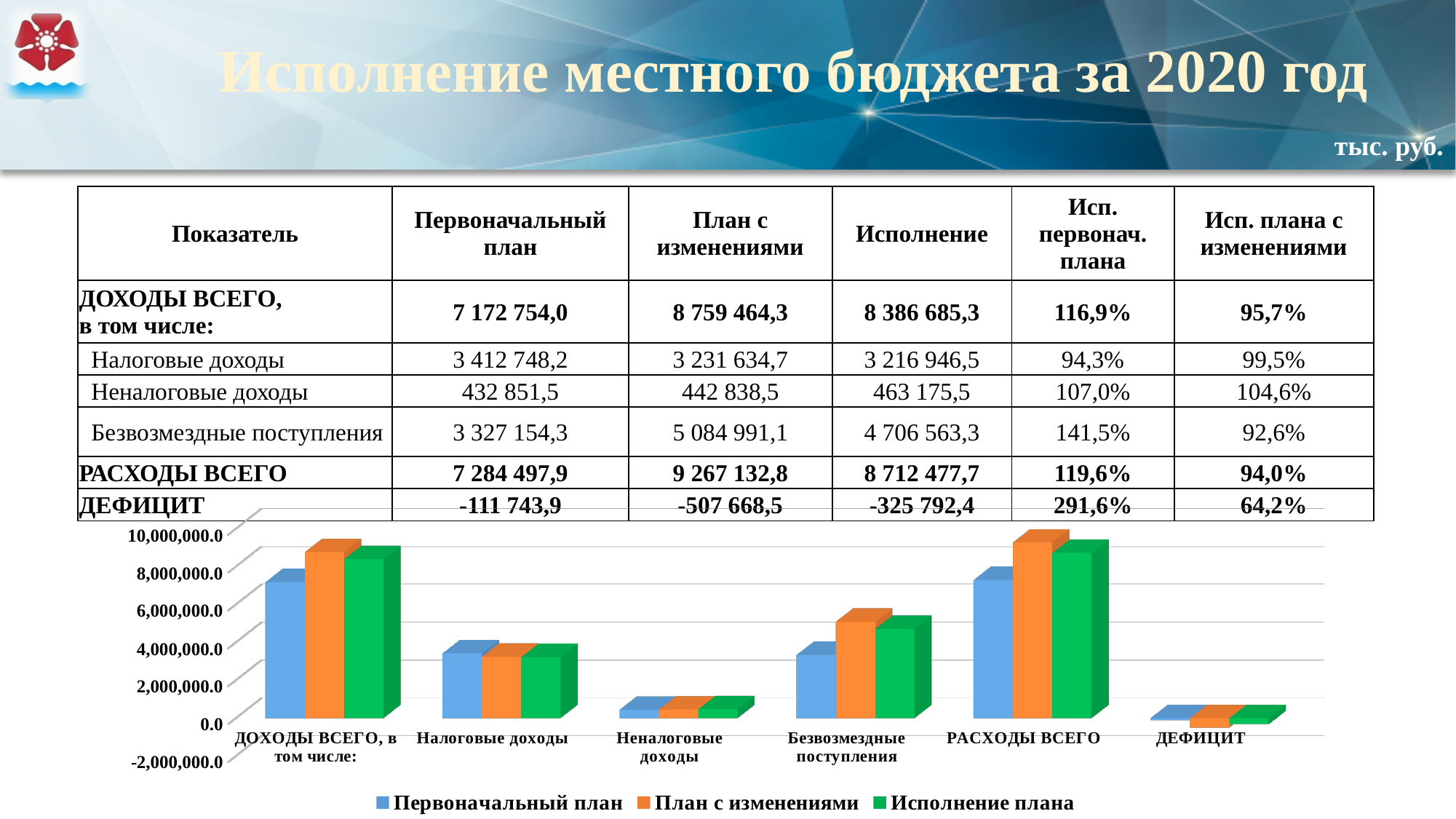
How many categories are shown along the x axis of the chart? 6 For the 'Исполнение плана' series, which is larger: 'Налоговые доходы' or 'Безвозмездные поступления'? Безвозмездные поступления Is the 'Исполнение плана' value for 'Неналоговые доходы' greater or less than 2,000,000.0? less What kind of chart is shown on the slide? bar chart Is the 'Первоначальный план' value for 'ДОХОДЫ ВСЕГО, в том числе:' greater or less than 8,000,000.0? less How many series does the chart legend list? 3 Is the 'План с изменениями' value for 'Безвозмездные поступления' greater or less than 4,000,000.0? greater For the 'План с изменениями' series, which is larger: 'ДОХОДЫ ВСЕГО, в том числе:' or 'РАСХОДЫ ВСЕГО'? РАСХОДЫ ВСЕГО What is the lowest value shown on the chart's vertical axis? -2,000,000.0 Which series in the chart is shown in orange? План с изменениями Which category has the lowest bars in the chart? ДЕФИЦИТ Which category has the tallest bar in the chart? РАСХОДЫ ВСЕГО